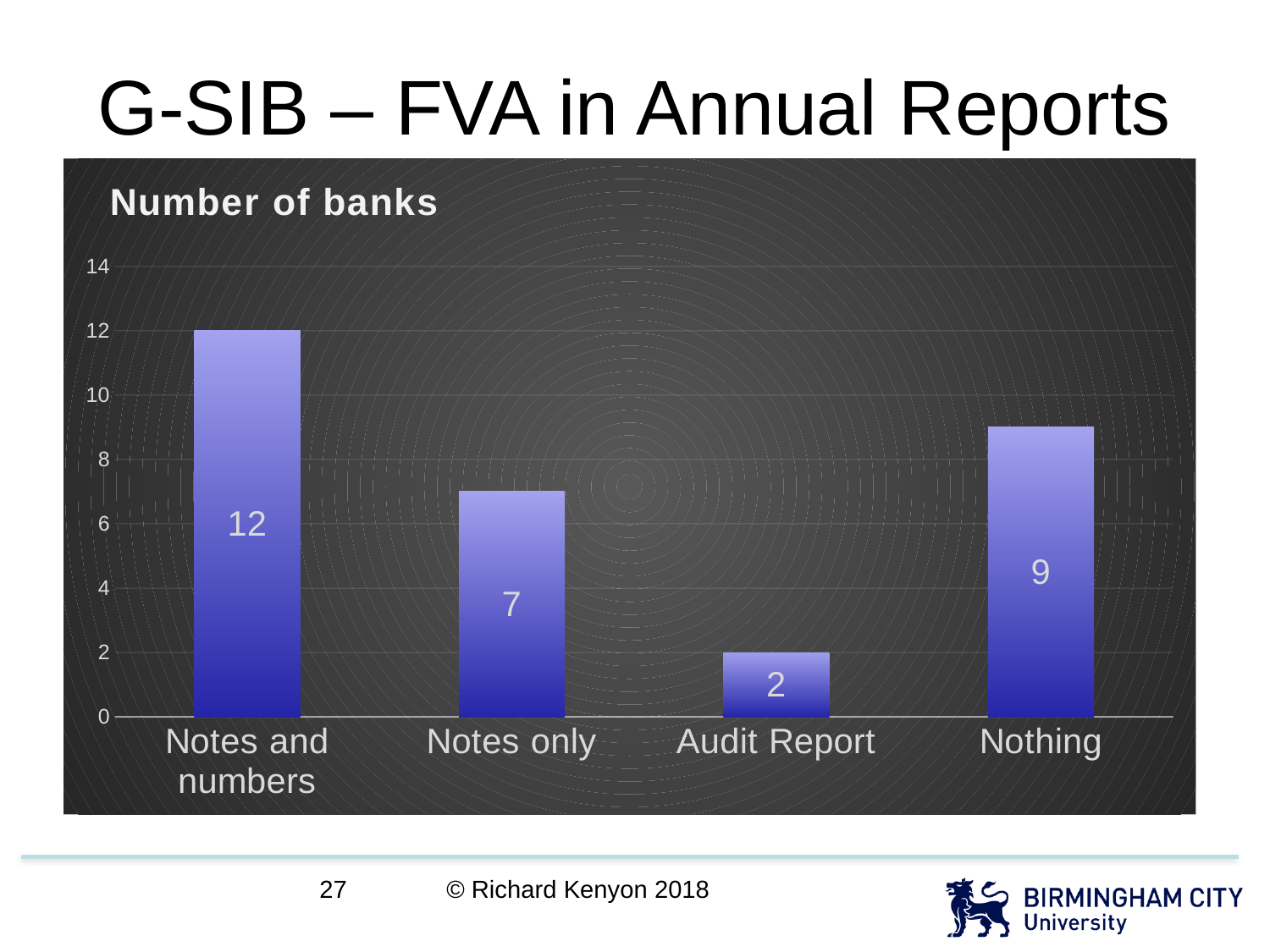
What is the difference between the number of banks for 'Notes only' and 'Audit Report'? 5 What is the number of banks for 'Notes only'? 7 What is the difference between the number of banks for 'Notes and numbers' and 'Nothing'? 3 Which category has the lowest number of banks? Audit Report Is the value for 'Nothing' greater or less than 10? less What kind of chart is shown on the slide? Bar chart What is the number of banks for 'Notes and numbers'? 12 Which has more banks, 'Notes only' or 'Nothing'? Nothing Which category has the highest number of banks? Notes and numbers What is the number of banks for 'Audit Report'? 2 What is the number of banks for 'Nothing'? 9 How many categories are shown in the chart? 4